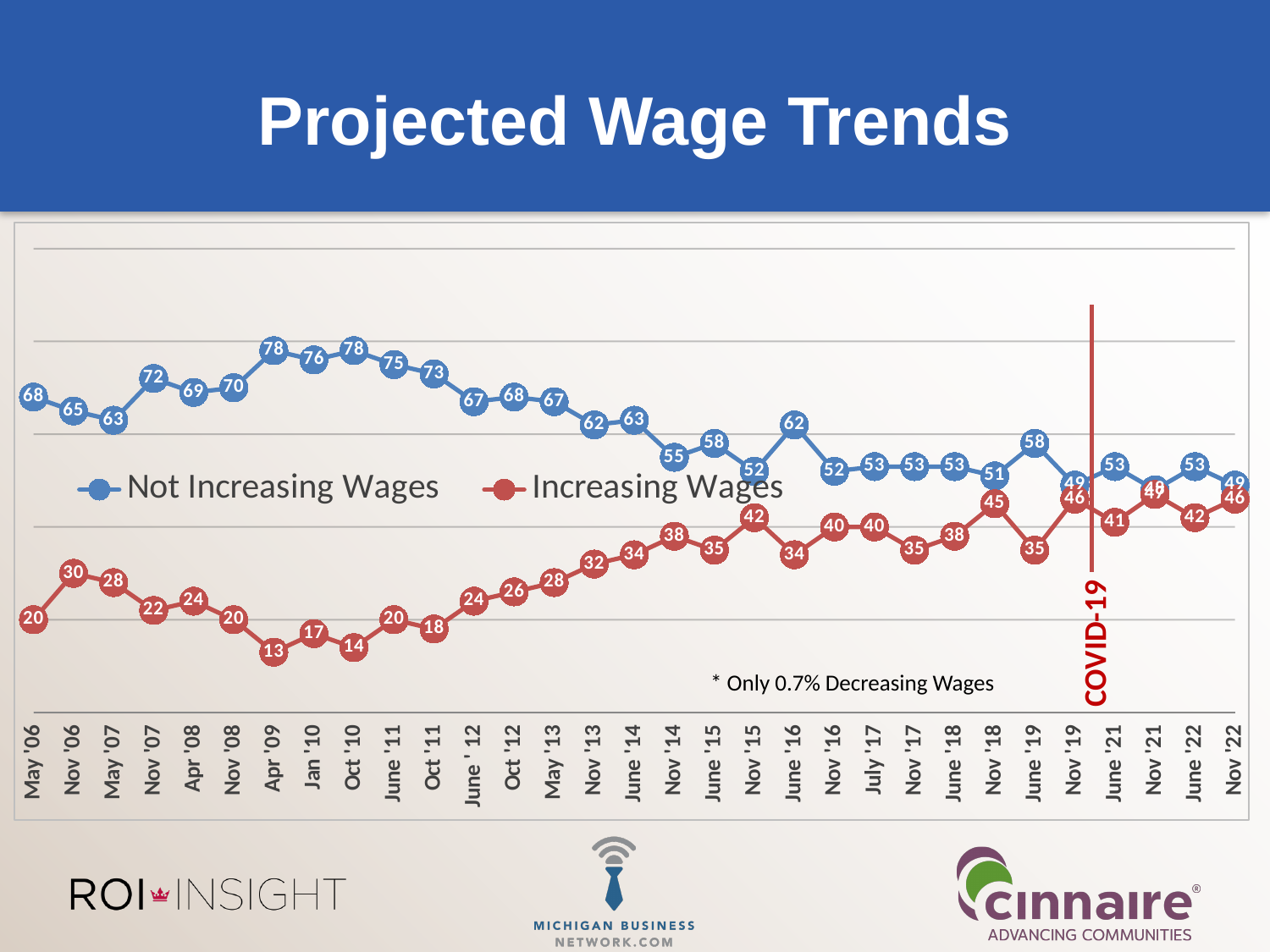
What event does the vertical red line on the chart mark? COVID-19 How many time periods are shown on the x axis? 31 What is the difference between Not Increasing Wages and Increasing Wages in Nov '15? 10 What is the value for Not Increasing Wages in May '06? 68 What kind of chart is shown on the slide? line chart What is the value for Increasing Wages in Apr '09? 13 How many series does the legend list? 2 Does the Not Increasing Wages series rise or fall from Oct '10 to Nov '14? fall In June '16, which series has the larger value, Not Increasing Wages or Increasing Wages? Not Increasing Wages In which period is the Increasing Wages series at its lowest? Apr '09 What is the value for Increasing Wages in Nov '22? 46 What is the value for Not Increasing Wages in Oct '10? 78